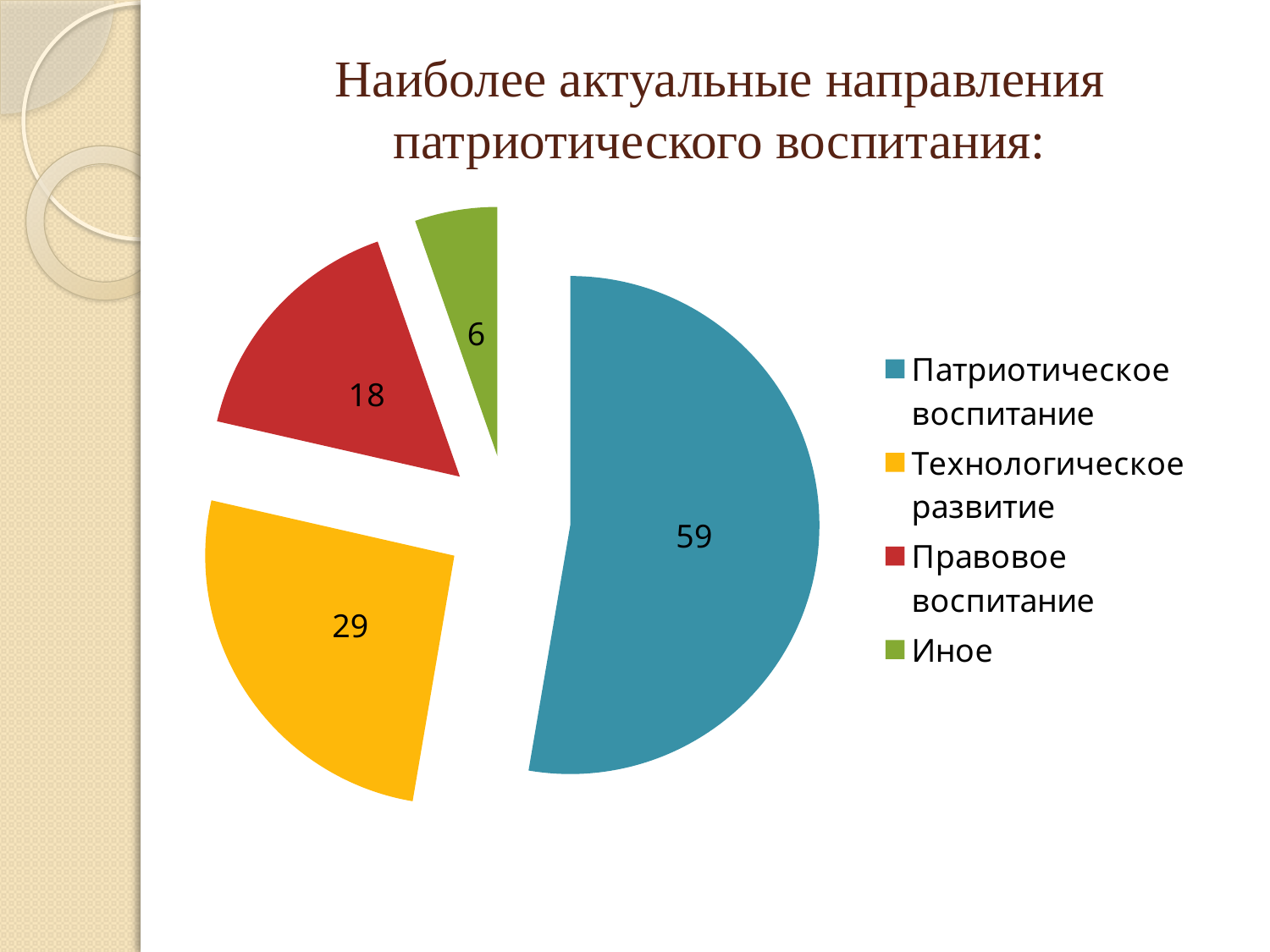
What is the value for Патриотическое воспитание? 59 What is the difference between the values for Правовое воспитание and Иное? 12 Which category has the smallest slice? Иное Which is larger, Технологическое развитие or Правовое воспитание? Технологическое развитие Which category has the largest slice? Патриотическое воспитание What type of chart is shown on the slide? Pie chart What is the difference between the values for Патриотическое воспитание and Технологическое развитие? 30 How many categories does the pie chart have? 4 What is the value for Технологическое развитие? 29 What is the value for Иное? 6 What is the value for Правовое воспитание? 18 What colour is the slice for Иное? Green